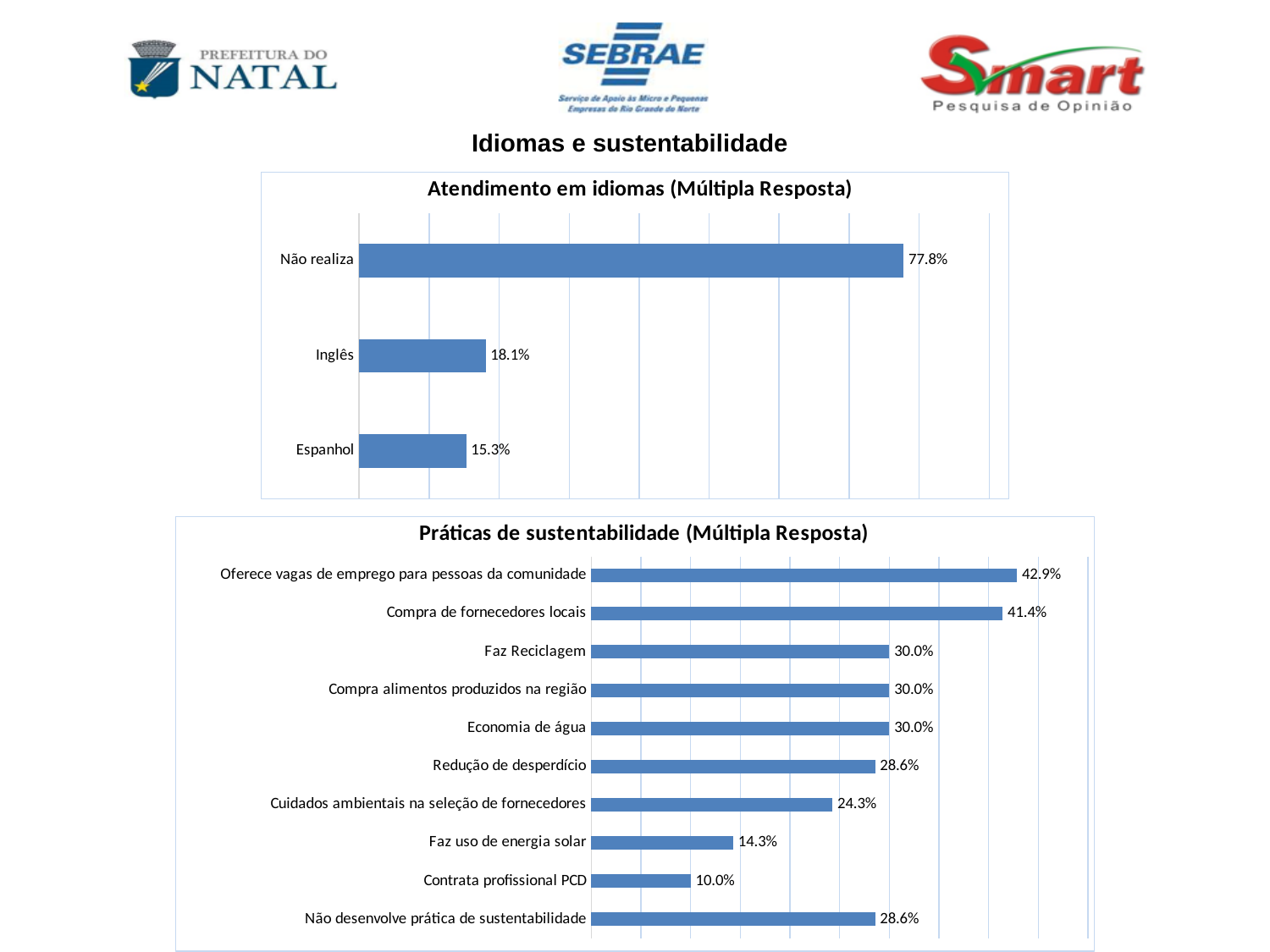
In the 'Atendimento em idiomas (Múltipla Resposta)' chart, what is the value for Inglês? 18.1% In the 'Práticas de sustentabilidade (Múltipla Resposta)' chart, what is the value for Faz uso de energia solar? 14.3% In the 'Atendimento em idiomas (Múltipla Resposta)' chart, how many categories are shown? 3 In the 'Práticas de sustentabilidade (Múltipla Resposta)' chart, which category has the lowest value? Contrata profissional PCD What kind of chart is the 'Práticas de sustentabilidade (Múltipla Resposta)' chart? Bar chart In the 'Práticas de sustentabilidade (Múltipla Resposta)' chart, which is larger: Redução de desperdício or Cuidados ambientais na seleção de fornecedores? Redução de desperdício In the 'Práticas de sustentabilidade (Múltipla Resposta)' chart, which category has the highest value? Oferece vagas de emprego para pessoas da comunidade In the 'Práticas de sustentabilidade (Múltipla Resposta)' chart, what is the value for Compra de fornecedores locais? 41.4% In the 'Práticas de sustentabilidade (Múltipla Resposta)' chart, how many categories are shown? 10 In the 'Atendimento em idiomas (Múltipla Resposta)' chart, which category has the highest value? Não realiza In the 'Atendimento em idiomas (Múltipla Resposta)' chart, what is the difference between the values for Inglês and Espanhol? 2.8% In the 'Atendimento em idiomas (Múltipla Resposta)' chart, which category has the lowest value? Espanhol